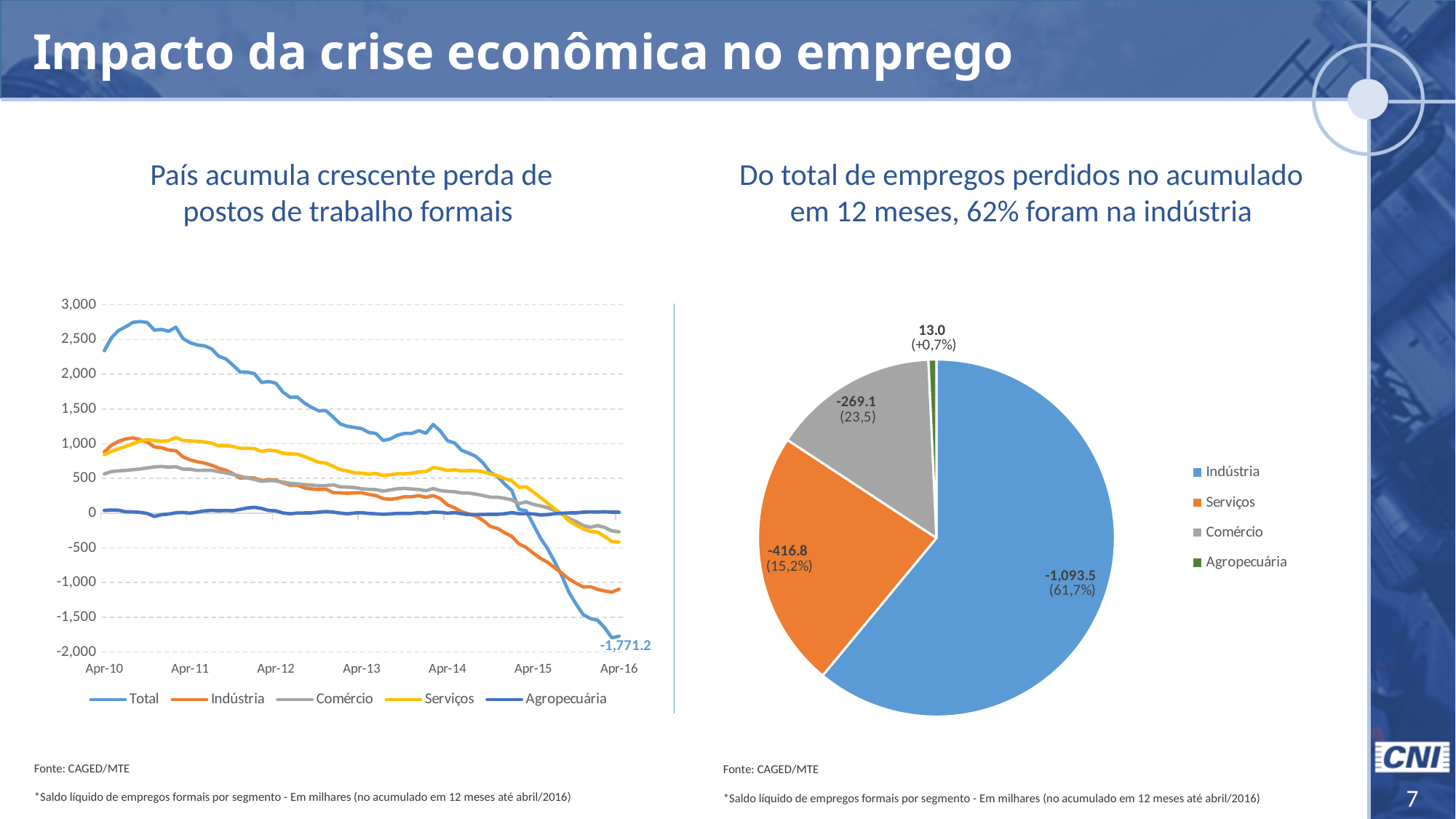
What kind of chart is the chart on the right of the slide? pie chart In the line chart on the left, what is the value of the Total series at Apr-16? -1,771.2 In the line chart on the left, how many series does the legend list? 5 In the pie chart on the right, what value is shown for Serviços? -416.8 In the pie chart on the right, what value is shown for Indústria? -1,093.5 What kind of chart is the chart on the left of the slide? line chart In the line chart on the left, does the Total series rise or fall from Apr-10 to Apr-16? fall In the pie chart on the right, which category has the smallest slice? Agropecuária In the pie chart on the right, how many categories does the legend list? 4 In the pie chart on the right, what share of the pie does Indústria represent? 61,7% In the line chart on the left, is the value of the Total series at Apr-10 greater or less than 2,000? greater In the pie chart on the right, what value is shown for Comércio? -269.1